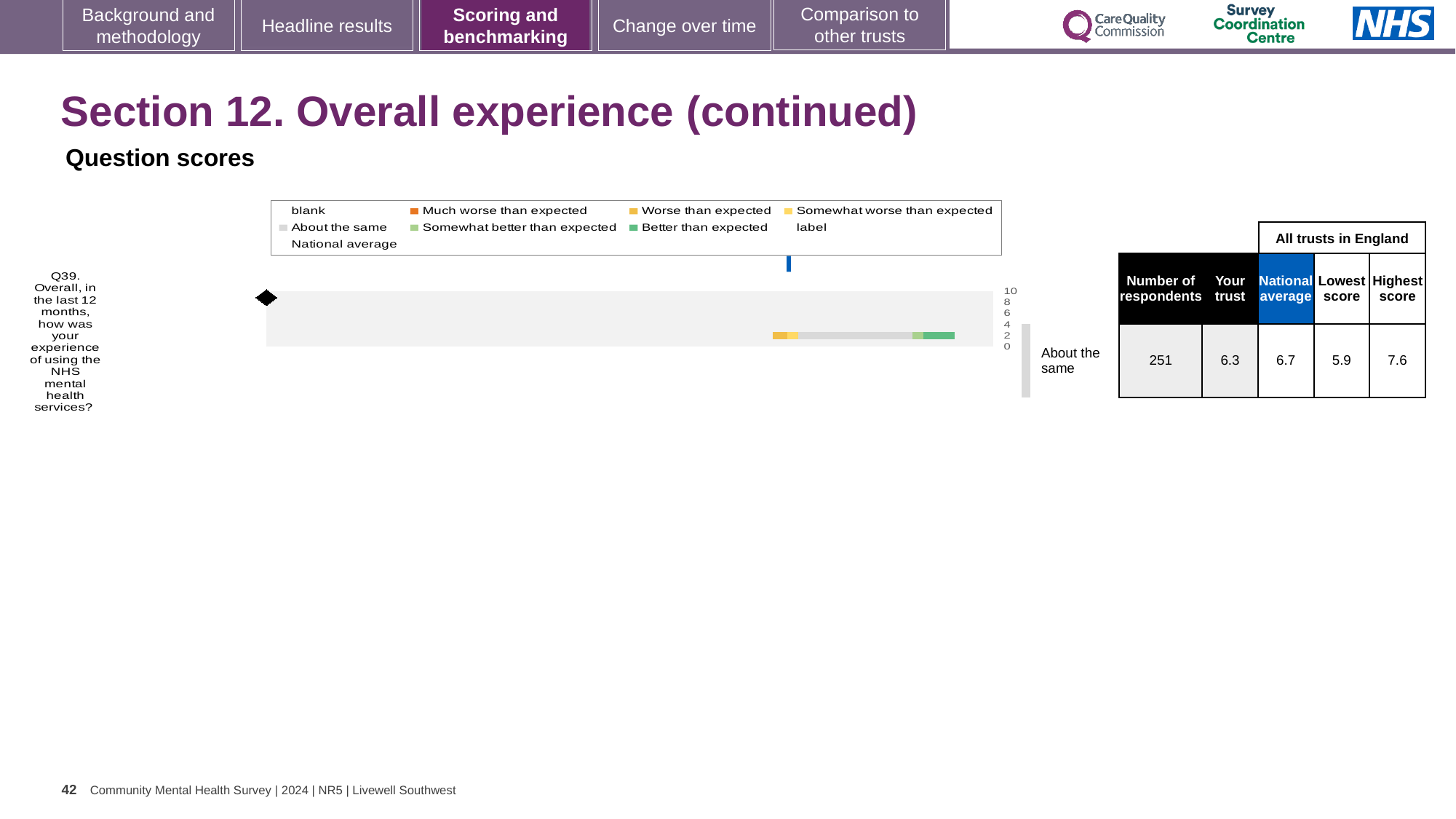
How many survey questions are plotted on this chart? 1 What is the difference between the highest and lowest trust scores for Q39? 1.7 What is the national average score for Q39? 6.7 For Q39, which is higher: the trust's score or the national average? National average What is the 'Your trust' score for Q39 (Overall, in the last 12 months, how was your experience of using the NHS mental health services?)? 6.3 According to the legend, what colour represents 'Much worse than expected'? Orange What is the lowest score among all trusts in England for Q39? 5.9 Which benchmarking category is the trust's Q39 score placed in? About the same What is the highest score among all trusts in England for Q39? 7.6 By how much does the national average exceed the trust's score for Q39? 0.4 How many respondents answered Q39? 251 What kind of chart is used to show the Q39 question score? Bar chart